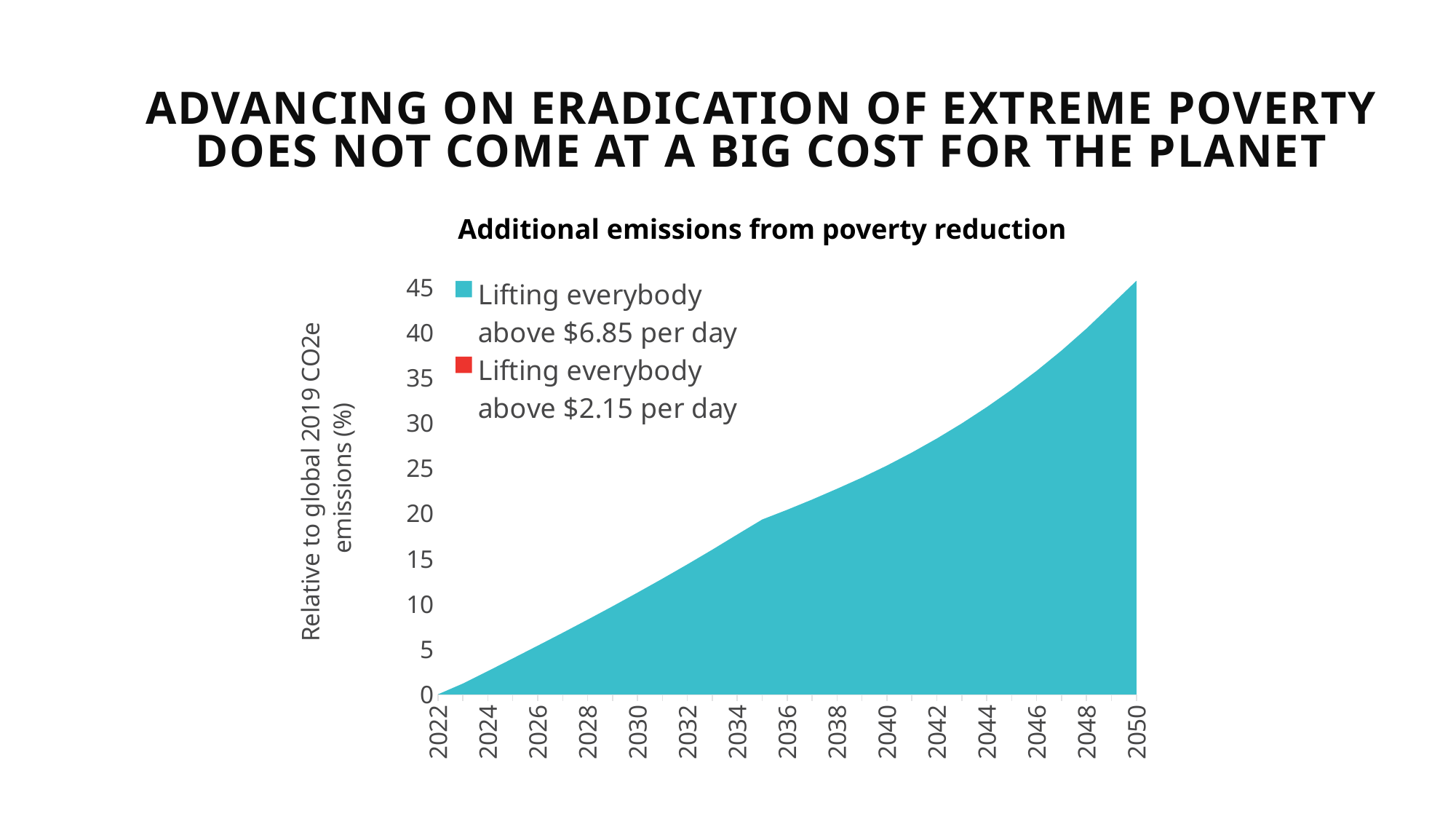
In which year are the additional emissions for lifting everybody above $6.85 per day lowest? 2022 What kind of chart is shown on the slide? Area chart Is the value for lifting everybody above $6.85 per day in 2042 greater or less than 25? greater What is the label of the vertical axis? Relative to global 2019 CO2e emissions (%) Is the value for lifting everybody above $6.85 per day in 2050 greater or less than 40? greater Do the additional emissions for lifting everybody above $6.85 per day rise or fall from 2022 to 2050? Rise Which year has the larger value for lifting everybody above $6.85 per day, 2030 or 2046? 2046 Is the value for lifting everybody above $6.85 per day in 2034 greater or less than 20? less How many series does the legend list? 2 In which year are the additional emissions for lifting everybody above $6.85 per day highest? 2050 What is the title of the chart? Additional emissions from poverty reduction